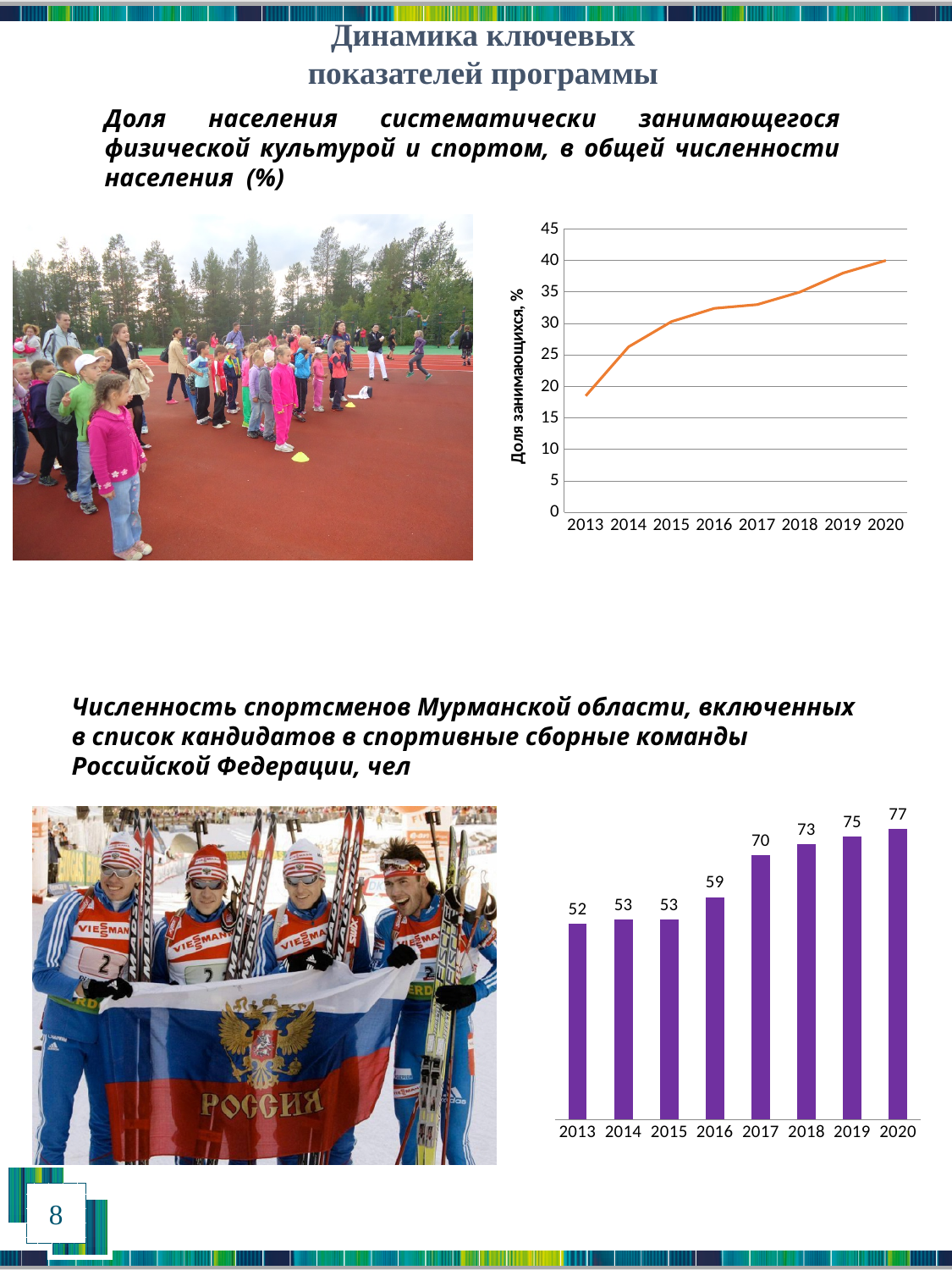
In the bottom bar chart, what is the difference between the values for 2020 and 2013? 25 In the top line chart, is the value for 2015 greater or less than 25? greater In the bottom bar chart, which year has the highest value? 2020 In the bottom bar chart, what is the value for 2017? 70 In the top line chart, is the value for 2020 greater or less than 35? greater In the top line chart, how many years are shown on the x axis? 8 In the top line chart, do the values rise or fall from 2013 to 2020? rise In the top line chart, is the value for 2013 greater or less than 20? less What kind of chart is the bottom chart on the slide? bar chart In the bottom bar chart, what is the value for 2016? 59 What kind of chart is the top chart on the slide? line chart In the bottom bar chart, which year has the lowest value? 2013